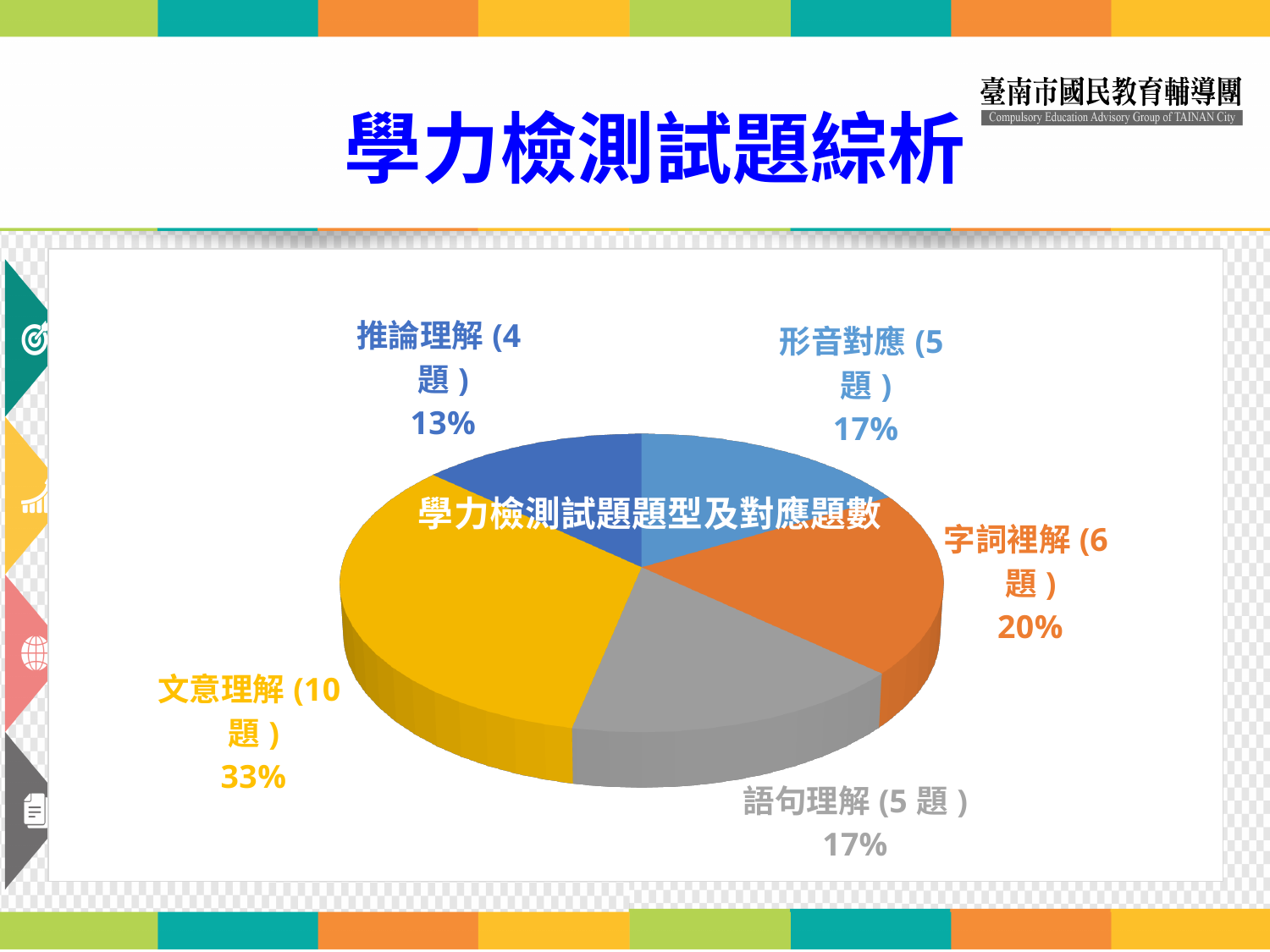
Which question type has the smallest share of the pie? 推論理解 Which has a larger share, 字詞裡解 or 形音對應? 字詞裡解 How many slices (question types) does the pie chart have? 5 What is the difference in percentage points between the shares of 文意理解 and 推論理解? 20 percentage points How many more questions does 文意理解 have than 推論理解? 6 How many questions does 字詞裡解 correspond to according to the chart label? 6 題 Which question type has the largest share of the pie? 文意理解 What colour is the 文意理解 slice of the pie chart? Yellow What is the title of the pie chart? 學力檢測試題題型及對應題數 What percentage share does 文意理解 have in the pie chart? 33% What percentage share does 推論理解 have in the pie chart? 13% What kind of chart is shown on the slide? Pie chart